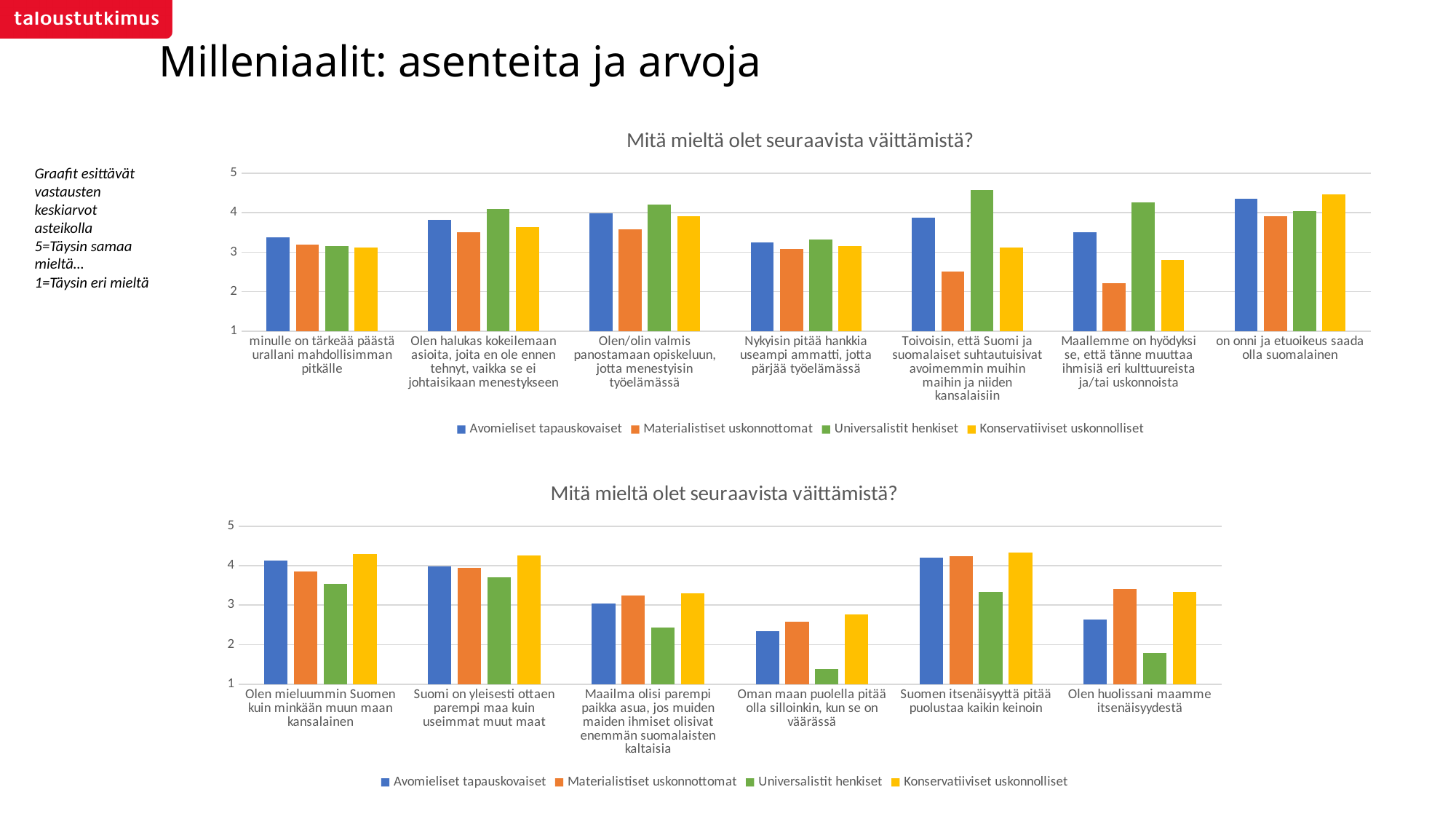
In the top chart, for the statement 'Toivoisin, että Suomi ja suomalaiset suhtautuisivat avoimemmin muihin maihin ja niiden kansalaisiin', which is larger: Universalistit henkiset or Materialistiset uskonnottomat? Universalistit henkiset What colour are the bars for Materialistiset uskonnottomat in the charts? orange In the bottom chart, is the value of Universalistit henkiset for 'Olen huolissani maamme itsenäisyydestä' greater or less than 2? less In the top chart, is the value of Konservatiiviset uskonnolliset for 'on onni ja etuoikeus saada olla suomalainen' greater or less than 4? greater What kind of chart is the top chart on the slide? bar chart How many statements (categories) are shown on the x axis of the top chart? 7 In the top chart, which group has the highest value for the statement 'Toivoisin, että Suomi ja suomalaiset suhtautuisivat avoimemmin muihin maihin ja niiden kansalaisiin'? Universalistit henkiset How many series does the legend of the bottom chart list? 4 In the bottom chart, which group has the highest value for the statement 'Suomen itsenäisyyttä pitää puolustaa kaikin keinoin'? Konservatiiviset uskonnolliset In the top chart, which group has the lowest value for the statement 'Maallemme on hyödyksi se, että tänne muuttaa ihmisiä eri kulttuureista ja/tai uskonnoista'? Materialistiset uskonnottomat How many statements (categories) are shown on the x axis of the bottom chart? 6 In the bottom chart, which group has the lowest value for the statement 'Oman maan puolella pitää olla silloinkin, kun se on väärässä'? Universalistit henkiset